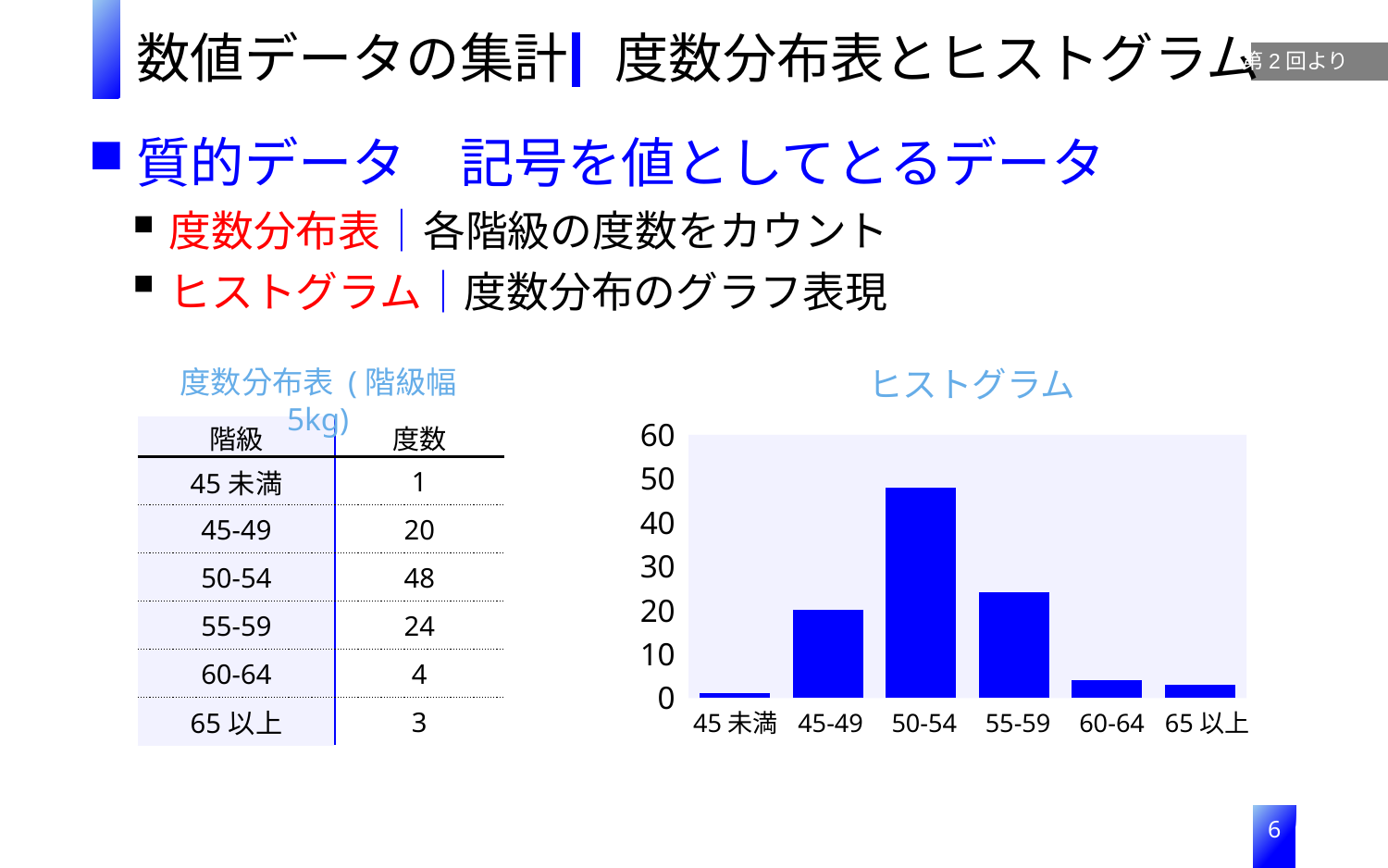
How many categories are shown on the x axis of the ヒストグラム chart? 6 Which category has the lowest bar in the ヒストグラム chart? 45 未満 According to the slide, what is the frequency (度数) for the 65 以上 class? 3 According to the slide, what is the frequency (度数) for the 50-54 class? 48 Which category has the highest bar in the ヒストグラム chart? 50-54 In the ヒストグラム chart, which is larger, the bar for 45-49 or the bar for 55-59? 55-59 What is the difference between the frequencies for 50-54 and 55-59 shown on the slide? 24 In the ヒストグラム chart, is the value for 50-54 greater or less than 40? greater In the ヒストグラム chart, is the value for 60-64 greater or less than 10? less In the ヒストグラム chart, is the value for 55-59 greater or less than 20? greater What is the title of the chart on the right of the slide? ヒストグラム What kind of chart is the ヒストグラム chart? bar chart